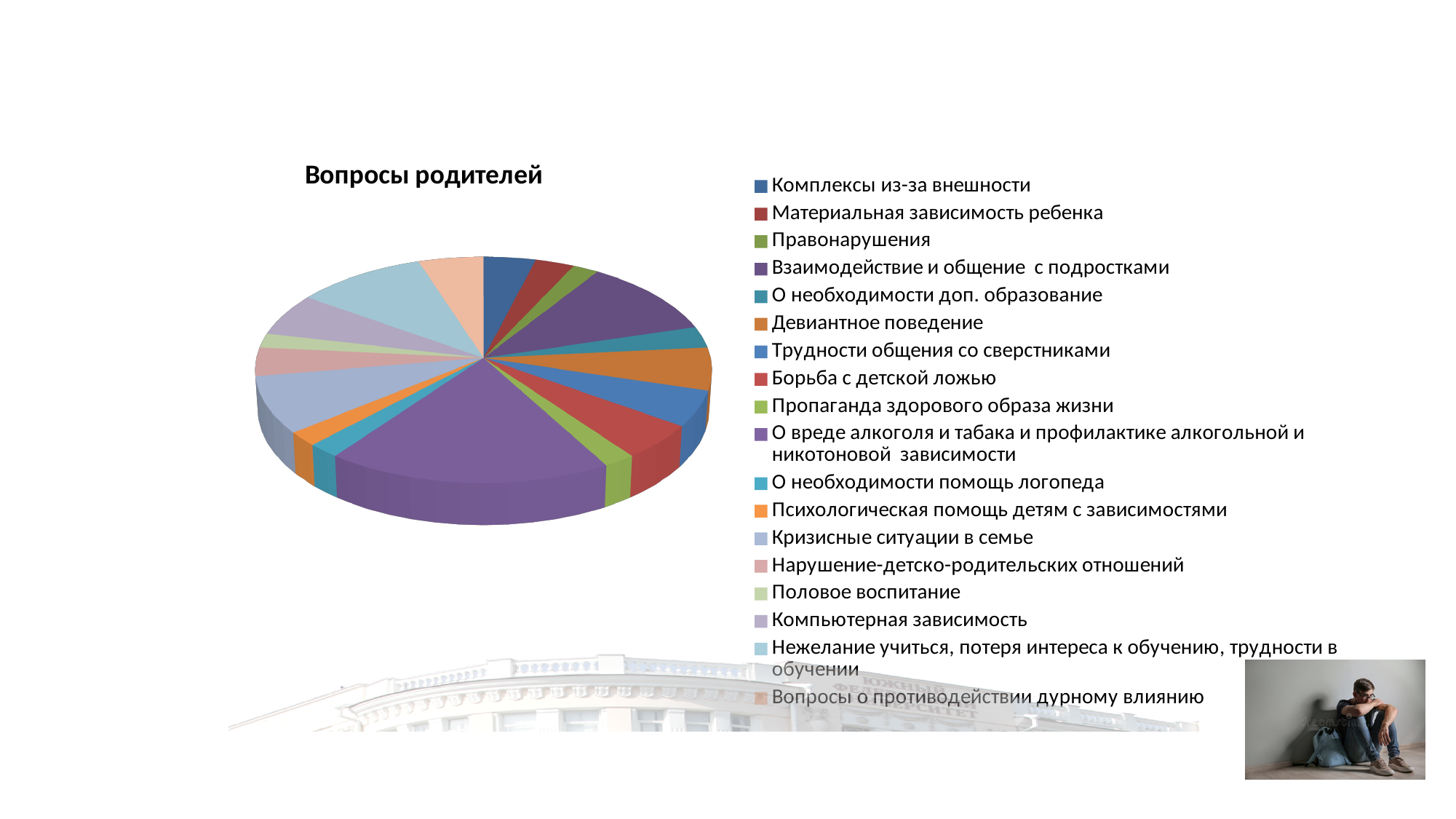
What is the title of the chart? Вопросы родителей Which slice is larger: "Кризисные ситуации в семье" or "Половое воспитание"? Кризисные ситуации в семье How many categories does the legend of the pie chart list? 18 Which slice is larger: "Взаимодействие и общение с подростками" or "Комплексы из-за внешности"? Взаимодействие и общение с подростками Which slice is larger: "Нежелание учиться, потеря интереса к обучению, трудности в обучении" or "О необходимости помощь логопеда"? Нежелание учиться, потеря интереса к обучению, трудности в обучении Which category has the largest slice of the pie? О вреде алкоголя и табака и профилактике алкогольной и никотоновой зависимости Does the pie chart display numeric data labels on its slices? No What kind of chart is shown on the slide? Pie chart Which category is shown in the first (top) entry of the legend? Комплексы из-за внешности